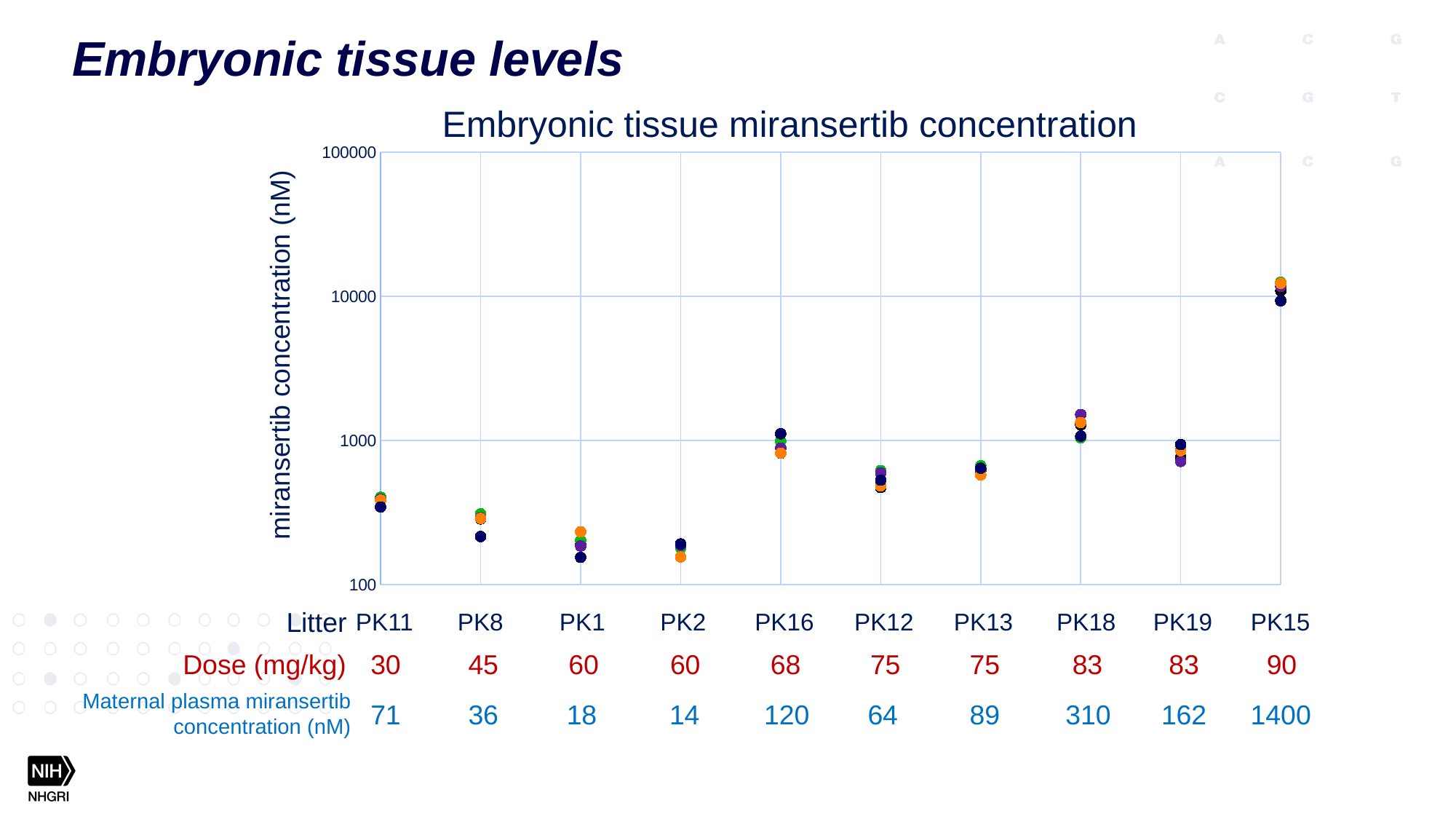
Which litter has higher embryonic tissue concentrations, PK16 or PK2? PK16 What is the label of the y axis of the chart? miransertib concentration (nM) Are the values for litter PK15 greater or less than 1000 nM? greater What dose (mg/kg) is listed for litter PK15 below the chart? 90 What kind of chart is shown on the slide? scatter chart How many litters are plotted along the x axis of the chart? 10 Are the values for litter PK2 greater or less than 1000 nM? less Are the values for litter PK13 greater or less than 1000 nM? less What is the title of the chart? Embryonic tissue miransertib concentration Which litter has the highest embryonic tissue miransertib concentration? PK15 Which litter has higher embryonic tissue concentrations, PK15 or PK8? PK15